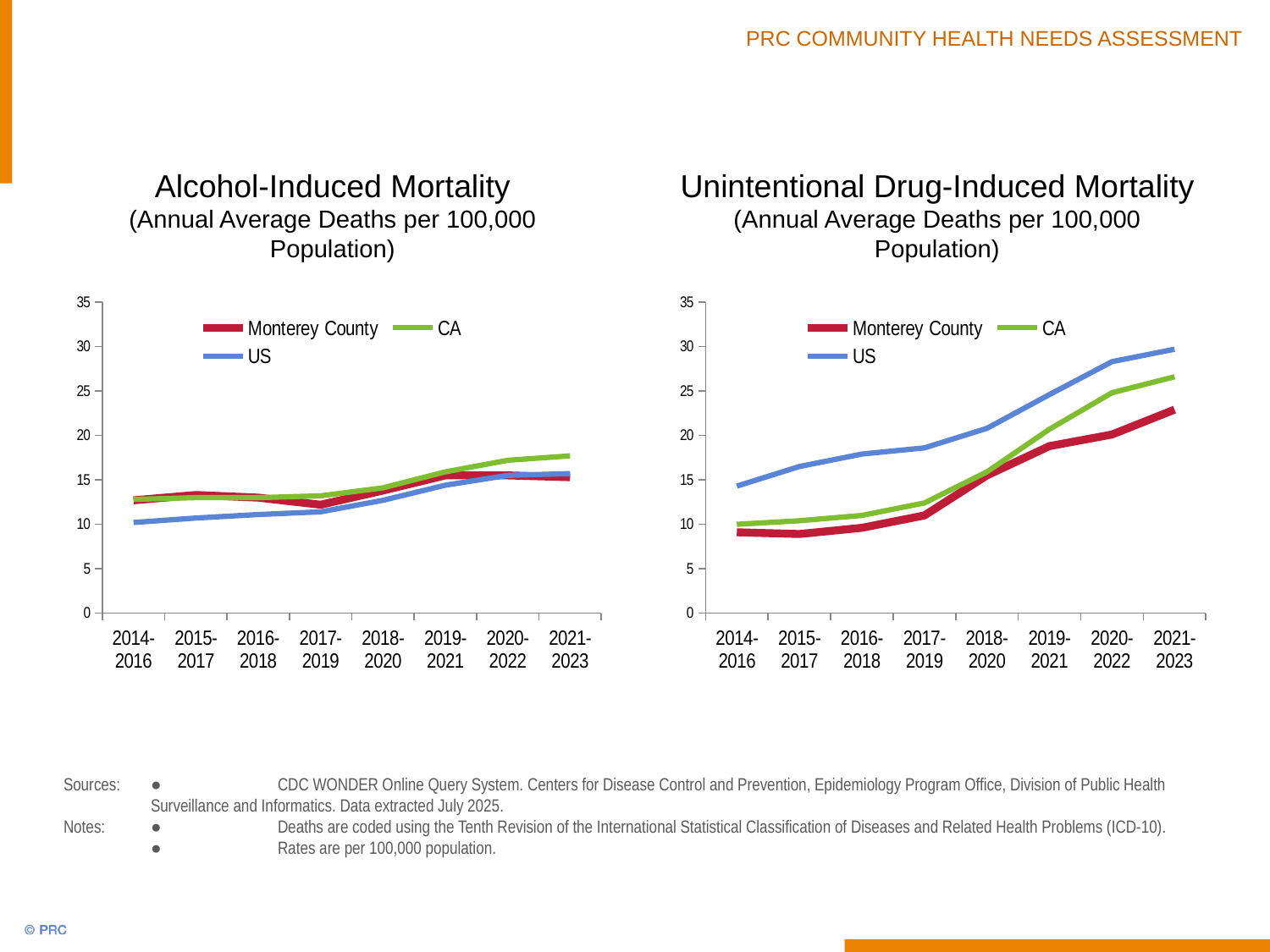
How many series does the legend list in the Unintentional Drug-Induced Mortality chart? 3 In the Unintentional Drug-Induced Mortality chart, does the Monterey County series rise or fall from 2014-2016 to 2021-2023? rise In the Alcohol-Induced Mortality chart, is the US value for 2014-2016 greater or less than 15? less What colour is the Monterey County line in the Alcohol-Induced Mortality chart? red In the Alcohol-Induced Mortality chart, which series has the lowest value in 2014-2016? US In the Alcohol-Induced Mortality chart, which series has the highest value in 2021-2023? CA In the Unintentional Drug-Induced Mortality chart, which is larger in 2019-2021: the US value or the Monterey County value? US In the Unintentional Drug-Induced Mortality chart, which series has the highest value in 2021-2023? US What type of chart is the Alcohol-Induced Mortality chart? line chart In the Unintentional Drug-Induced Mortality chart, which series has the lowest value in 2014-2016? Monterey County In the Unintentional Drug-Induced Mortality chart, is the US value for 2021-2023 greater or less than 25? greater How many time periods are shown on the x axis of the Alcohol-Induced Mortality chart? 8